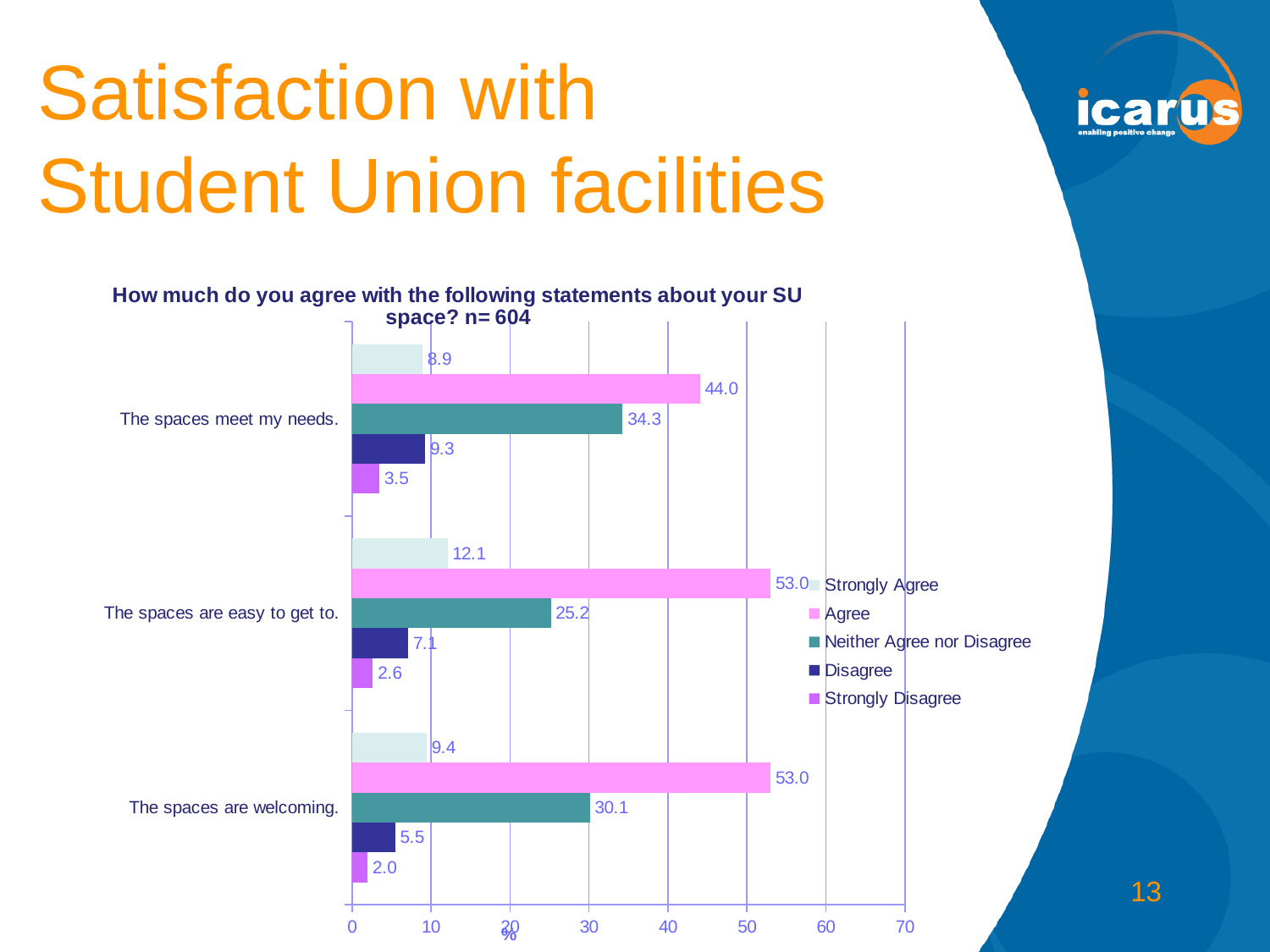
What is the sample size (n) given in the chart title? 604 What kind of chart is shown on the slide? Bar chart Which statement has the highest Strongly Disagree value? The spaces meet my needs. How many statements are shown on the chart? 3 How many series does the legend list? 5 What is the difference between the Agree values for 'The spaces are welcoming' and 'The spaces meet my needs'? 9.0 What percentage of respondents agree that the spaces meet their needs? 44.0 What is the value for Strongly Agree for 'The spaces are easy to get to'? 12.1 What is the value for Neither Agree nor Disagree for 'The spaces are welcoming'? 30.1 Is the Neither Agree nor Disagree value for 'The spaces are easy to get to' greater or less than 30? less Which statement has the lowest Agree value? The spaces meet my needs. Which is larger: the Disagree value for 'The spaces meet my needs' or for 'The spaces are easy to get to'? The spaces meet my needs.